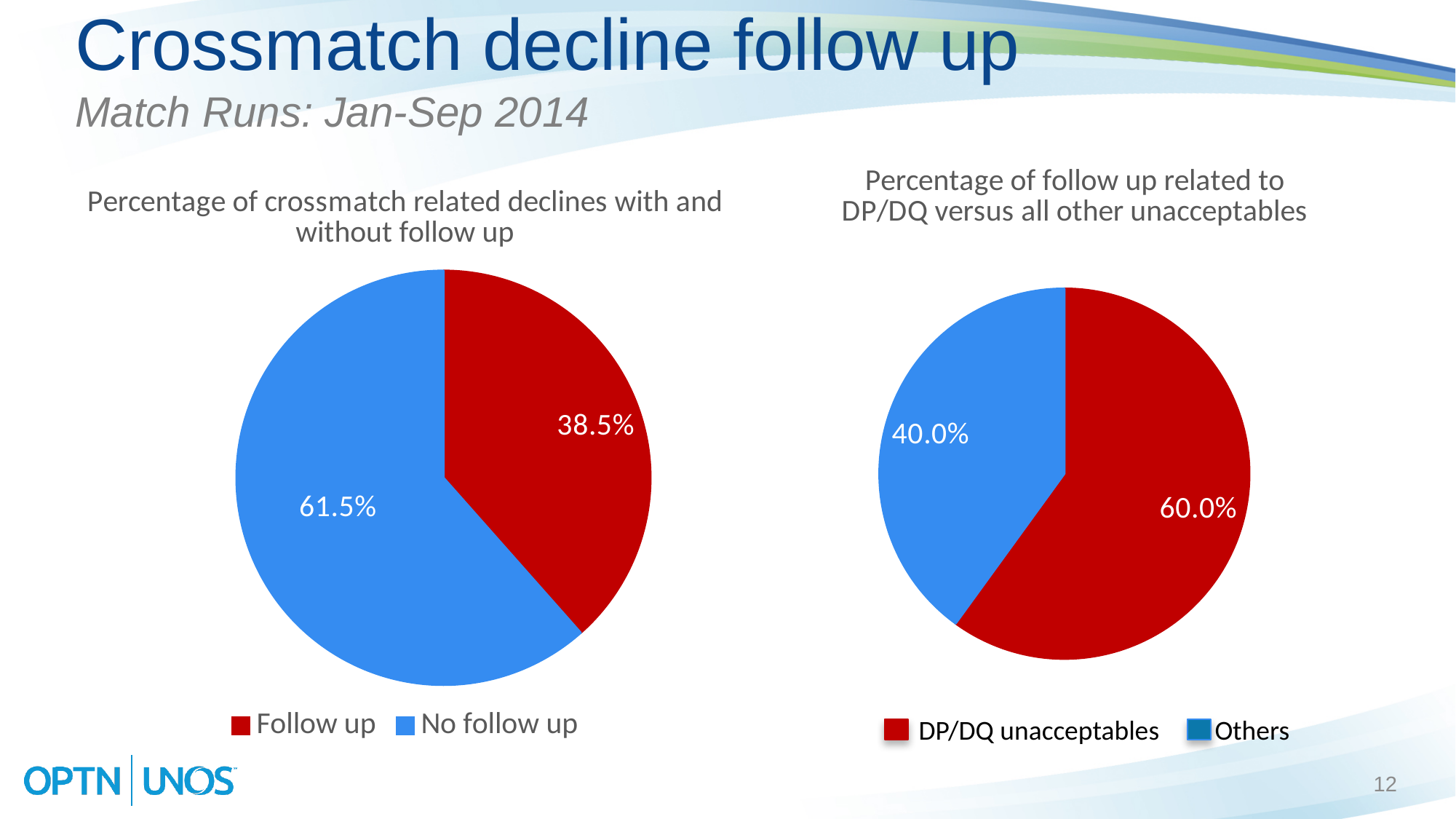
What type of chart is the left chart? Pie chart In the right chart (Percentage of follow up related to DP/DQ versus all other unacceptables), what percentage is shown for Others? 40.0% In the right chart, which category has the largest slice? DP/DQ unacceptables In the right chart (Percentage of follow up related to DP/DQ versus all other unacceptables), what percentage is shown for DP/DQ unacceptables? 60.0% How many entries does the legend of the left chart list? 2 In the left chart, which slice is larger: Follow up or No follow up? No follow up In the right chart, what colour is the DP/DQ unacceptables slice? Red In the left chart, what is the difference in percentage points between No follow up and Follow up? 23.0 percentage points In the left chart (Percentage of crossmatch related declines with and without follow up), what percentage is shown for No follow up? 61.5% How many slices does the right chart have? 2 In the right chart, what is the difference in percentage points between DP/DQ unacceptables and Others? 20.0 percentage points In the left chart (Percentage of crossmatch related declines with and without follow up), what percentage is shown for Follow up? 38.5%